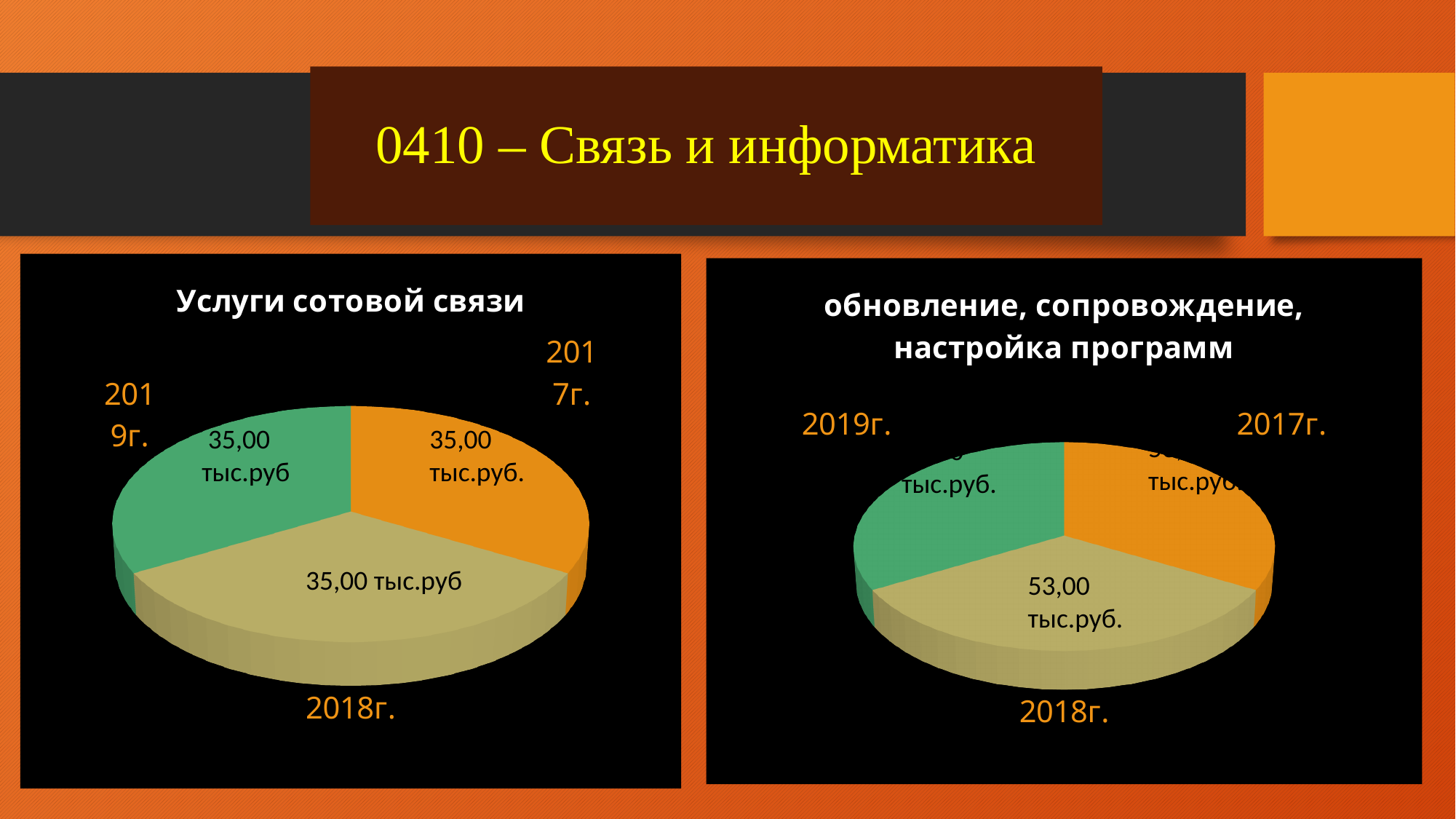
On the chart titled "обновление, сопровождение, настройка программ", what colour is the 2019г. slice? Green On the chart titled "Услуги сотовой связи", what is the value for 2017г.? 35,00 тыс.руб. On the chart titled "обновление, сопровождение, настройка программ", what is the value for 2018г.? 53,00 тыс.руб. On the chart titled "Услуги сотовой связи", what is the total of the three slices? 105,00 тыс.руб How many slices does the chart titled "обновление, сопровождение, настройка программ" have? 3 What kind of chart is the right chart on the slide? Pie chart What kind of chart is the left chart on the slide? Pie chart On the chart titled "Услуги сотовой связи", what is the value for 2018г.? 35,00 тыс.руб On the chart titled "Услуги сотовой связи", what is the value for 2019г.? 35,00 тыс.руб How many slices does the chart titled "Услуги сотовой связи" have? 3 What is the title of the left chart on the slide? Услуги сотовой связи